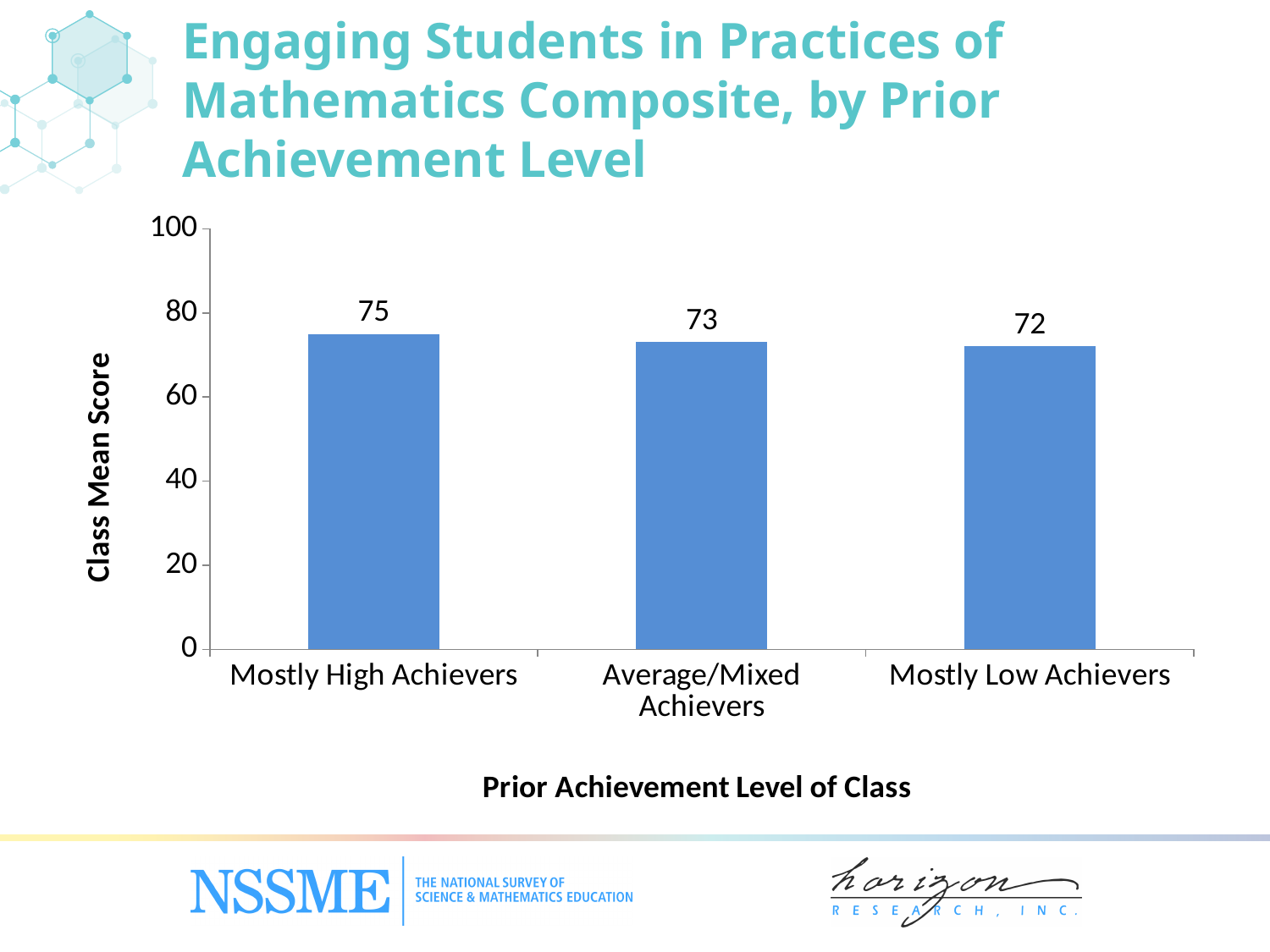
What kind of chart is shown on the slide? bar chart Is the class mean score for Mostly Low Achievers greater or less than 80? less What is the class mean score for Average/Mixed Achievers? 73 What is the difference between the class mean scores for Average/Mixed Achievers and Mostly Low Achievers? 1 Which has a higher class mean score, Mostly High Achievers or Average/Mixed Achievers? Mostly High Achievers What is the class mean score for Mostly Low Achievers? 72 What is the class mean score for Mostly High Achievers? 75 Which prior achievement level has the highest class mean score? Mostly High Achievers Do the class mean scores rise or fall from Mostly High Achievers to Mostly Low Achievers? fall Which prior achievement level has the lowest class mean score? Mostly Low Achievers What is the difference between the class mean scores for Mostly High Achievers and Mostly Low Achievers? 3 How many prior achievement level categories are shown on the chart? 3